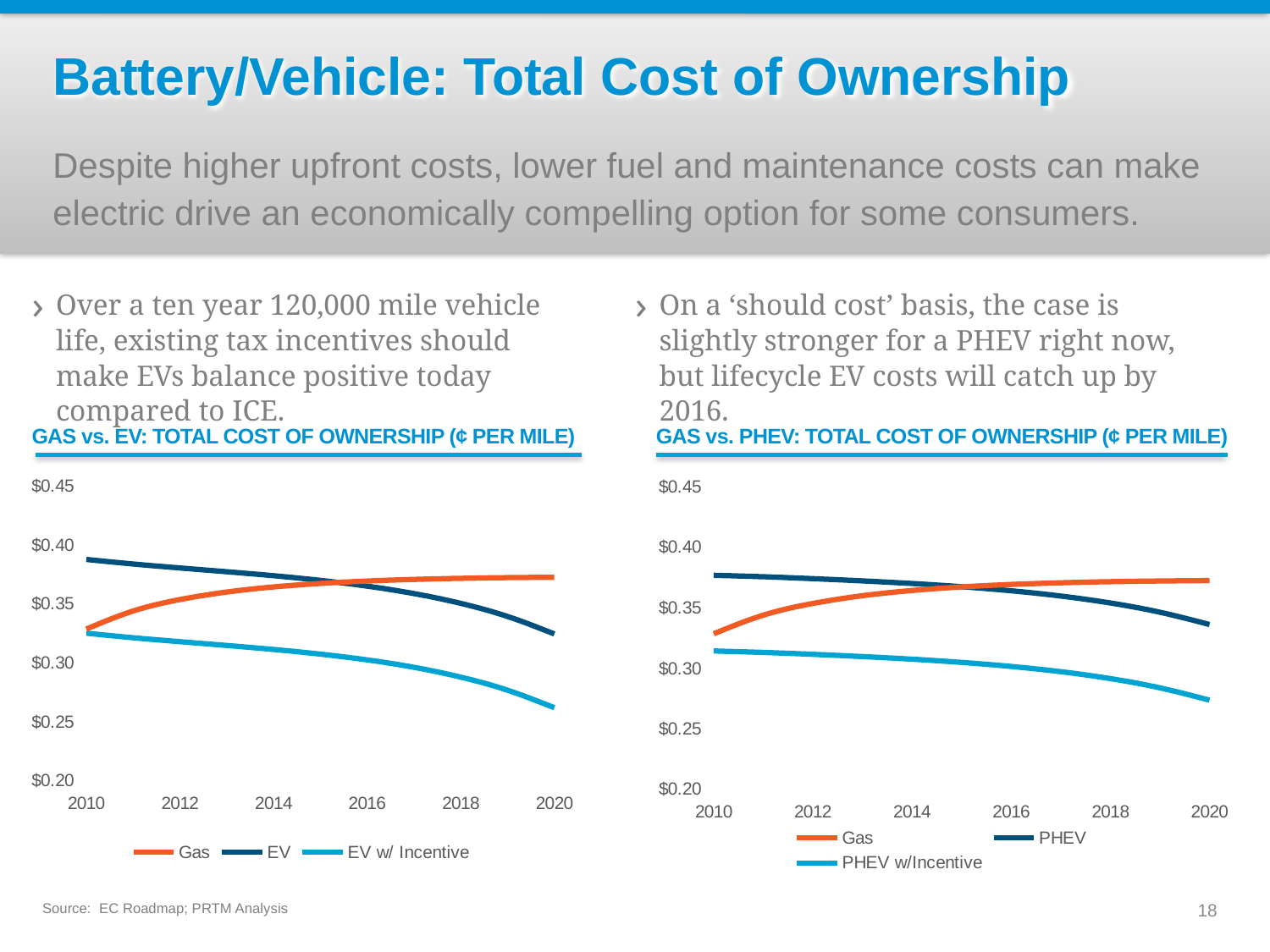
In the right chart (GAS vs. PHEV), is the value for PHEV w/Incentive in 2020 greater or less than $0.30? less In the left chart (GAS vs. EV), is the value for EV in 2010 greater or less than $0.35? greater In the left chart (GAS vs. EV), does the EV w/ Incentive line rise or fall from 2010 to 2020? fall What kind of chart is the 'GAS vs. EV: TOTAL COST OF OWNERSHIP' chart on the left? line chart In the left chart (GAS vs. EV), does the Gas line rise or fall from 2010 to 2020? rise In the left chart (GAS vs. EV), is the value for EV w/ Incentive in 2020 greater or less than $0.30? less In the right chart (GAS vs. PHEV), does the PHEV line rise or fall from 2010 to 2020? fall How many series does the legend of the right chart (GAS vs. PHEV) list? 3 How many series does the legend of the left chart (GAS vs. EV) list? 3 In the right chart (GAS vs. PHEV), which is larger in 2020: Gas or PHEV w/Incentive? Gas What is the title of the chart on the right side of the slide? GAS vs. PHEV: TOTAL COST OF OWNERSHIP (¢ PER MILE) In the left chart (GAS vs. EV), which is larger in 2010: Gas or EV? EV